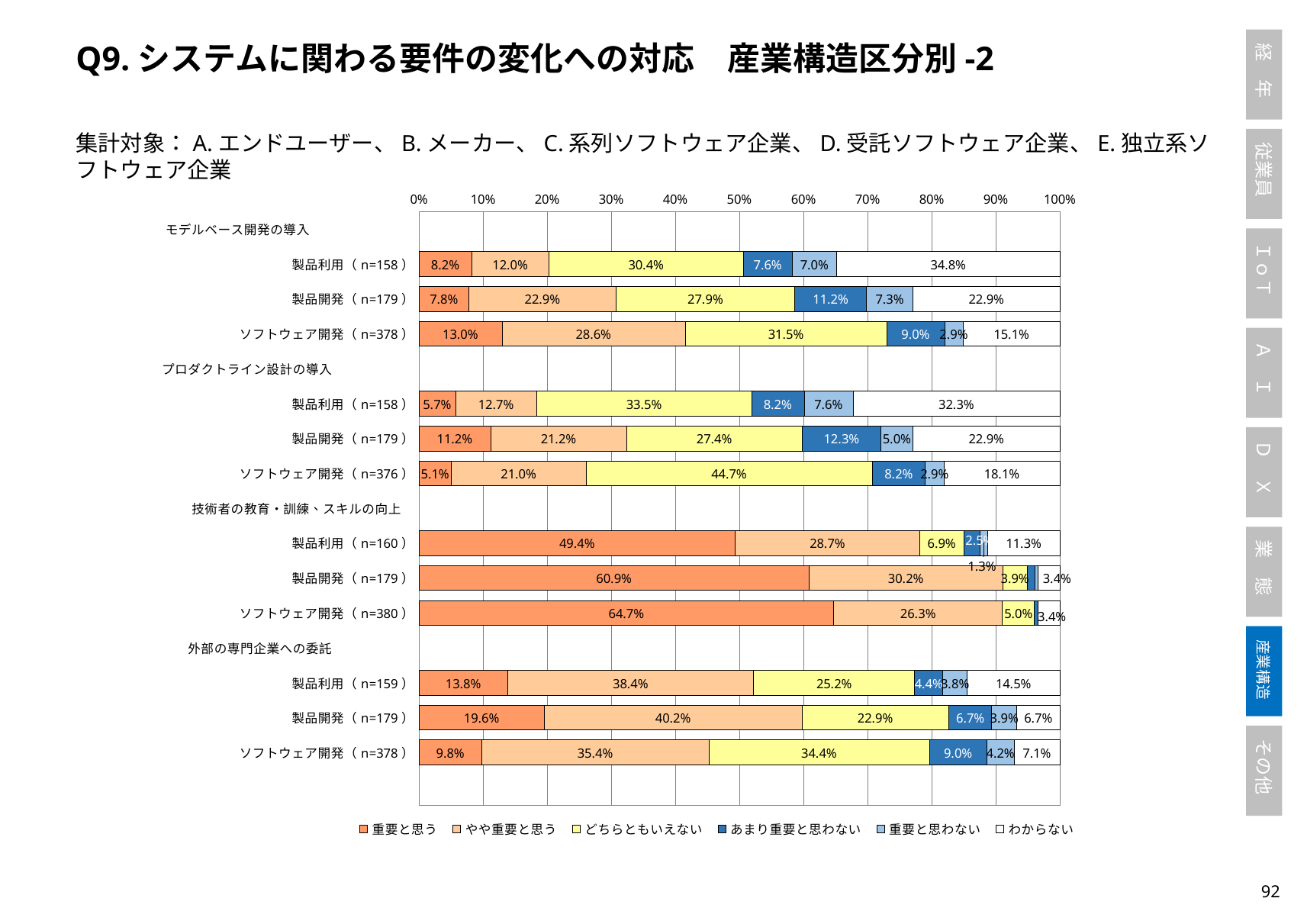
Within the 技術者の教育・訓練、スキルの向上 group, which respondent group has the lowest 重要と思う value? 製品利用 (n=160) How many bars (respondent groups) are plotted in the chart? 12 Which bar has the highest 重要と思う value in the chart? 技術者の教育・訓練、スキルの向上 ソフトウェア開発 (n=380) How many series does the legend list? 6 In the モデルベース開発の導入 group, what is the 重要と思う value for ソフトウェア開発 (n=378)? 13.0% What kind of chart is shown on the slide? Stacked bar chart In the プロダクトライン設計の導入 group, what is the どちらともいえない value for ソフトウェア開発 (n=376)? 44.7% In the 外部の専門企業への委託 group, which is larger: the 重要と思う value for 製品開発 (n=179) or for ソフトウェア開発 (n=378)? 製品開発 (n=179) What is the label of the first (leftmost) series in the legend? 重要と思う In the 外部の専門企業への委託 group, what is the やや重要と思う value for 製品開発 (n=179)? 40.2% In the 技術者の教育・訓練、スキルの向上 group, what is the 重要と思う value for ソフトウェア開発 (n=380)? 64.7% In the モデルベース開発の導入 group, what is the difference between the わからない values for 製品利用 (n=158) and ソフトウェア開発 (n=378)? 19.7%